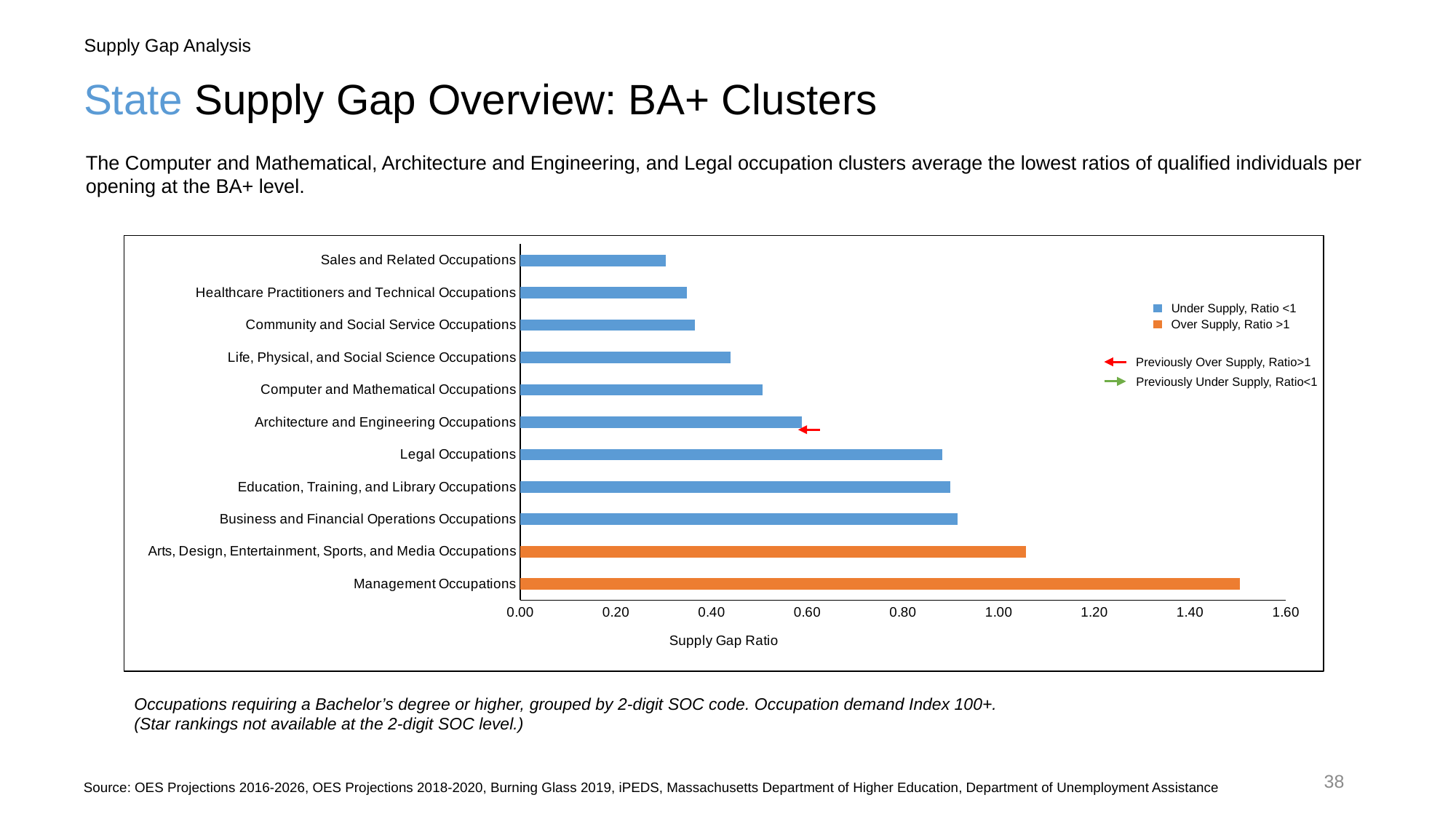
Is the supply gap ratio for Sales and Related Occupations greater or less than 0.40? less Is the supply gap ratio for Legal Occupations greater or less than 0.80? greater What is the title of the x axis of the chart? Supply Gap Ratio Which occupation cluster has the lowest supply gap ratio? Sales and Related Occupations Which occupation cluster has the highest supply gap ratio? Management Occupations Which has a larger supply gap ratio, Legal Occupations or Computer and Mathematical Occupations? Legal Occupations What kind of chart is shown on the slide? bar chart Is the supply gap ratio for Arts, Design, Entertainment, Sports, and Media Occupations greater or less than 1.00? greater How many occupation clusters are plotted in the chart? 11